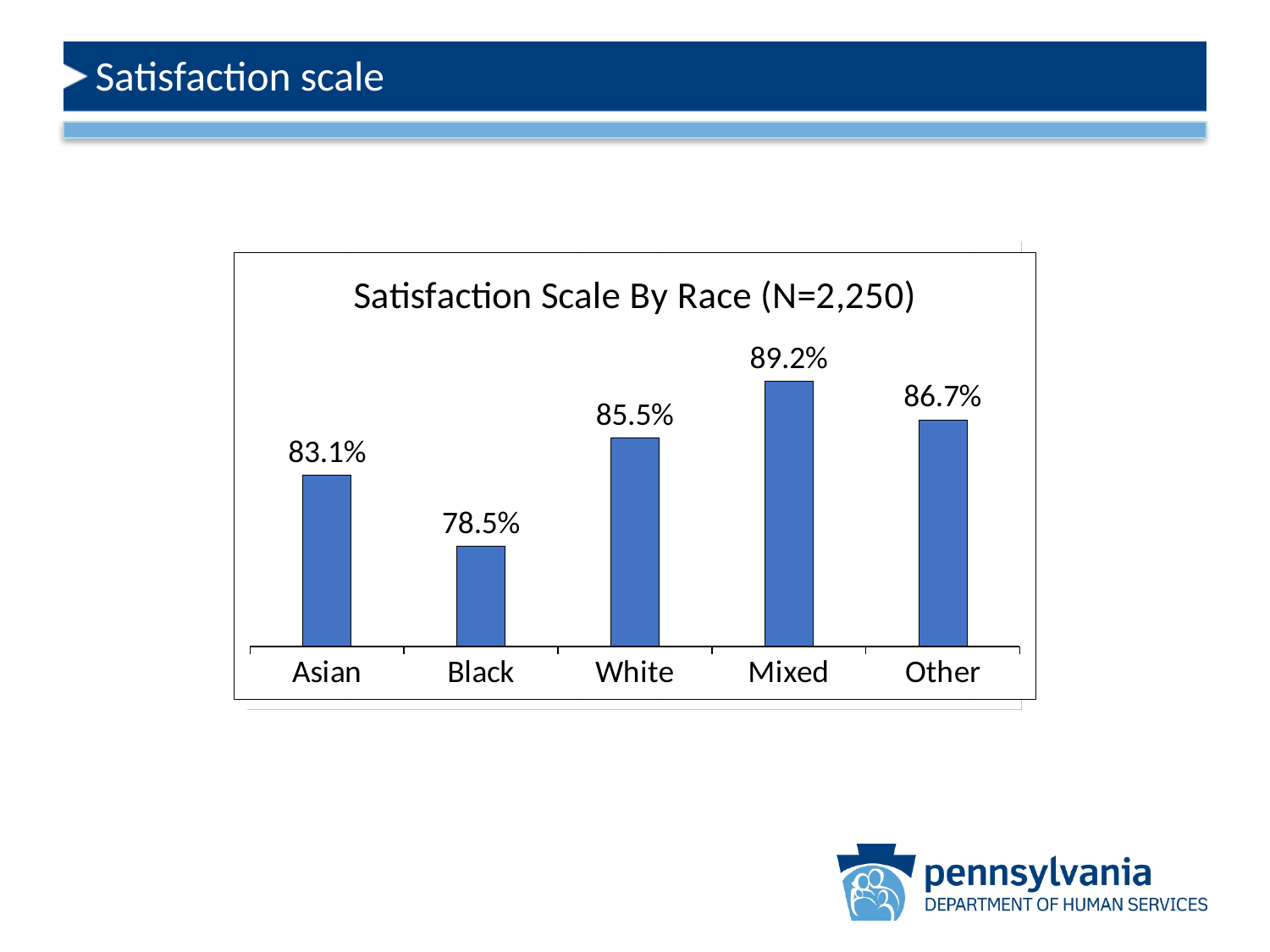
What is the satisfaction scale value for Black? 78.5% What is the difference between the satisfaction scale values for Mixed and Black? 10.7% What is the satisfaction scale value for Asian? 83.1% Which race category has the lowest satisfaction scale value? Black Which has a higher satisfaction scale value, Asian or White? White What is the difference between the satisfaction scale values for Other and White? 1.2% What is the satisfaction scale value for White? 85.5% What is the sample size (N) given in the chart title? 2,250 What kind of chart is shown on the slide? Bar chart What is the satisfaction scale value for Other? 86.7% How many race categories are shown in the chart? 5 Which race category has the highest satisfaction scale value? Mixed